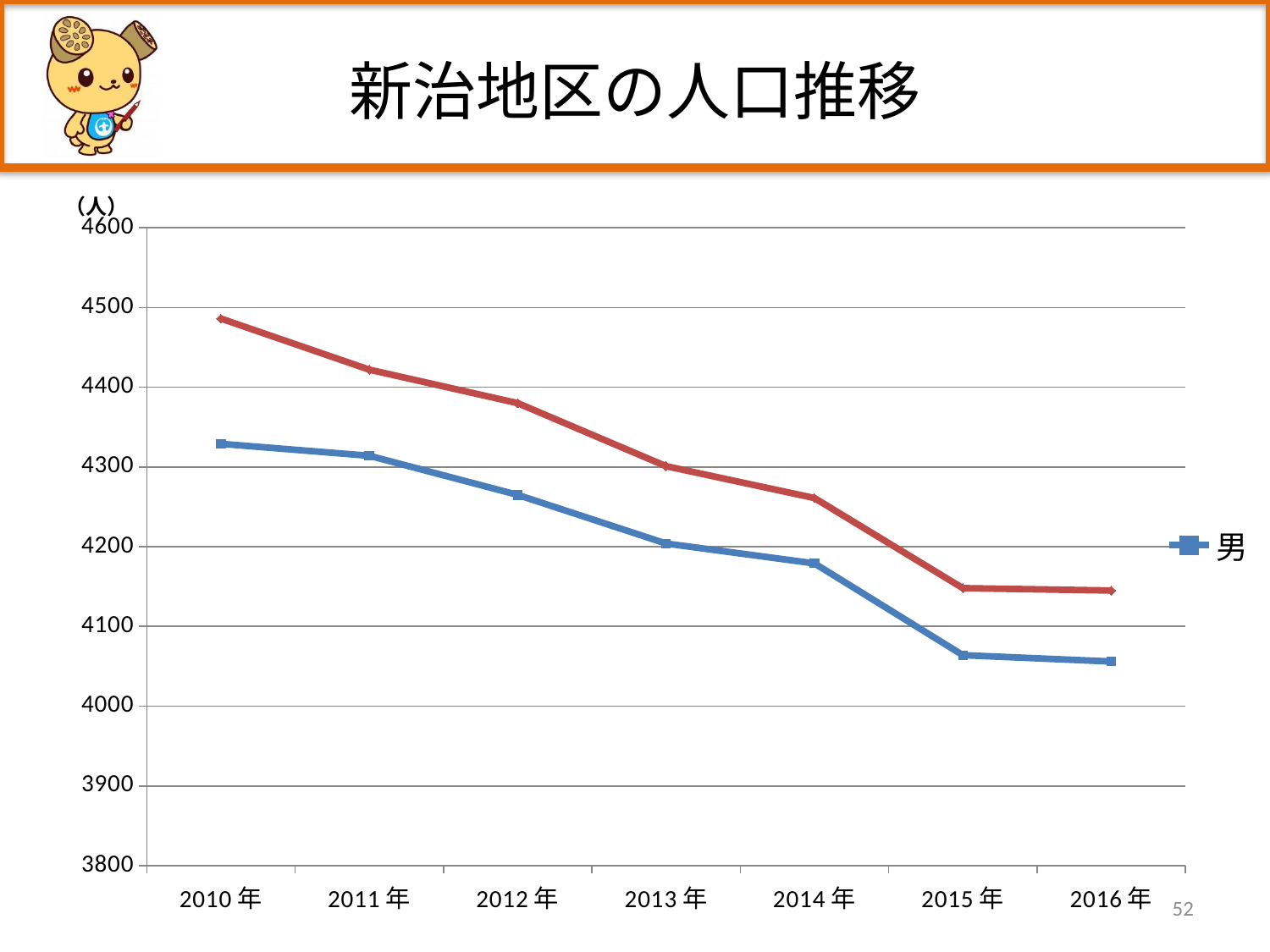
Does the 男 series rise or fall from 2010年 to 2016年? fall What is the title of the chart? 新治地区の人口推移 Which is larger for 男: the value in 2012年 or the value in 2015年? 2012年 Is the 男 value for 2016年 greater or less than 4100? less In which year is the 男 value highest? 2010年 What is the name of the series listed in the legend? 男 Is the 男 value for 2010年 greater or less than 4300? greater In which year is the 男 value lowest? 2016年 How many series does the legend list? 1 What kind of chart is shown on the slide? line chart How many years are plotted along the x axis? 7